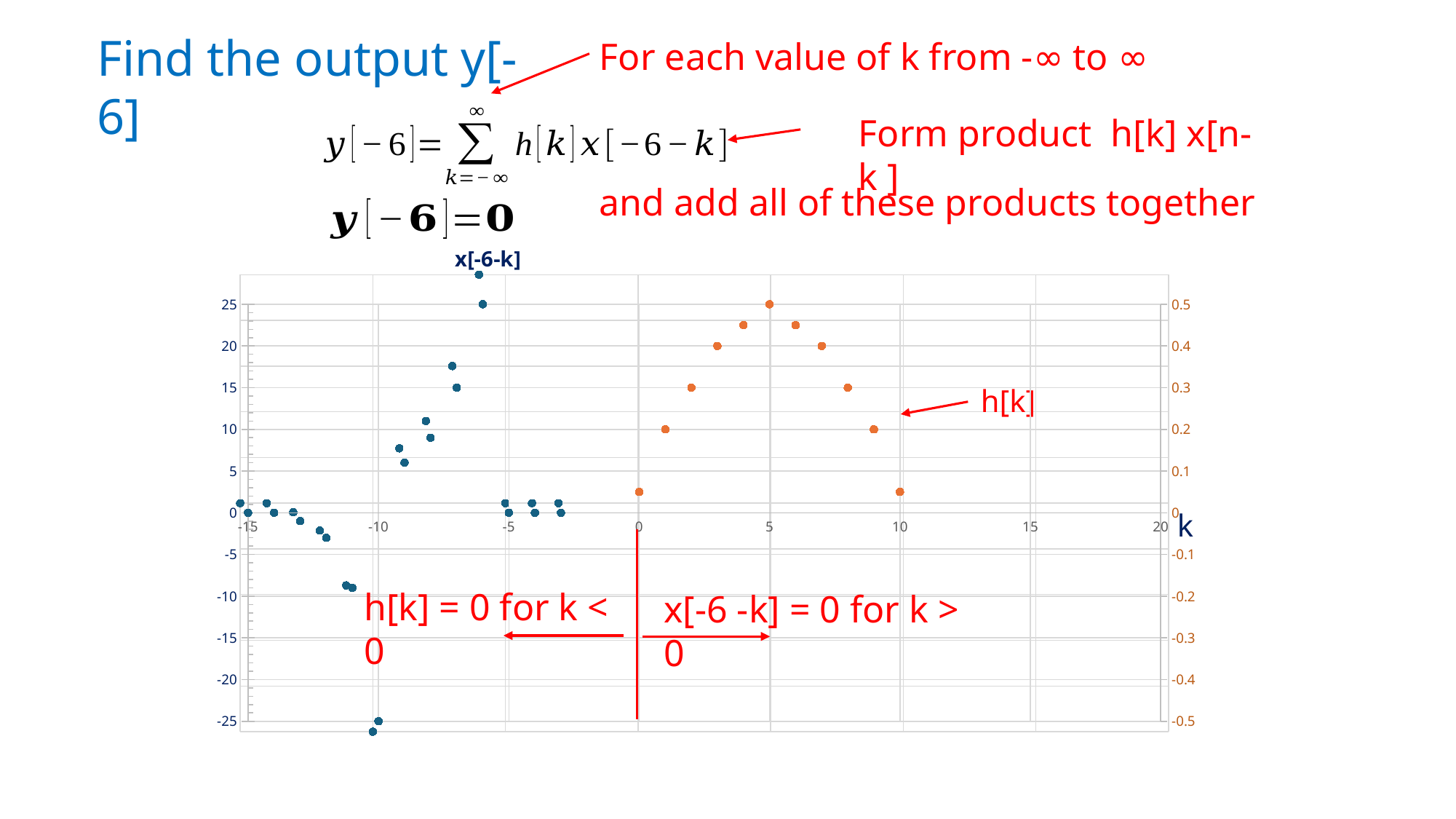
Which is larger, h[k] at k = 2 or h[k] at k = 4? k = 4 Is the value of x[-6-k] at k = -10 greater or less than -20 on the left-hand axis? less Is the highest value of x[-6-k] at k = -6 greater or less than 20 on the left-hand axis? greater What is the value of h[k] at k = 5, read on the right-hand axis? 0.5 Which is larger, x[-6-k] at k = -10 or x[-6-k] at k = -6? k = -6 How many orange h[k] points are plotted on the chart? 11 At which value of k does the h[k] series reach its highest point? 5 Is the value of h[k] at k = 3 greater or less than 0.3 on the right-hand axis? greater What label is shown on the horizontal axis of the chart? k Do the h[k] values rise or fall as k goes from 0 to 5? rise Do the h[k] values rise or fall as k goes from 5 to 10? fall What kind of chart is shown on the slide? scatter chart